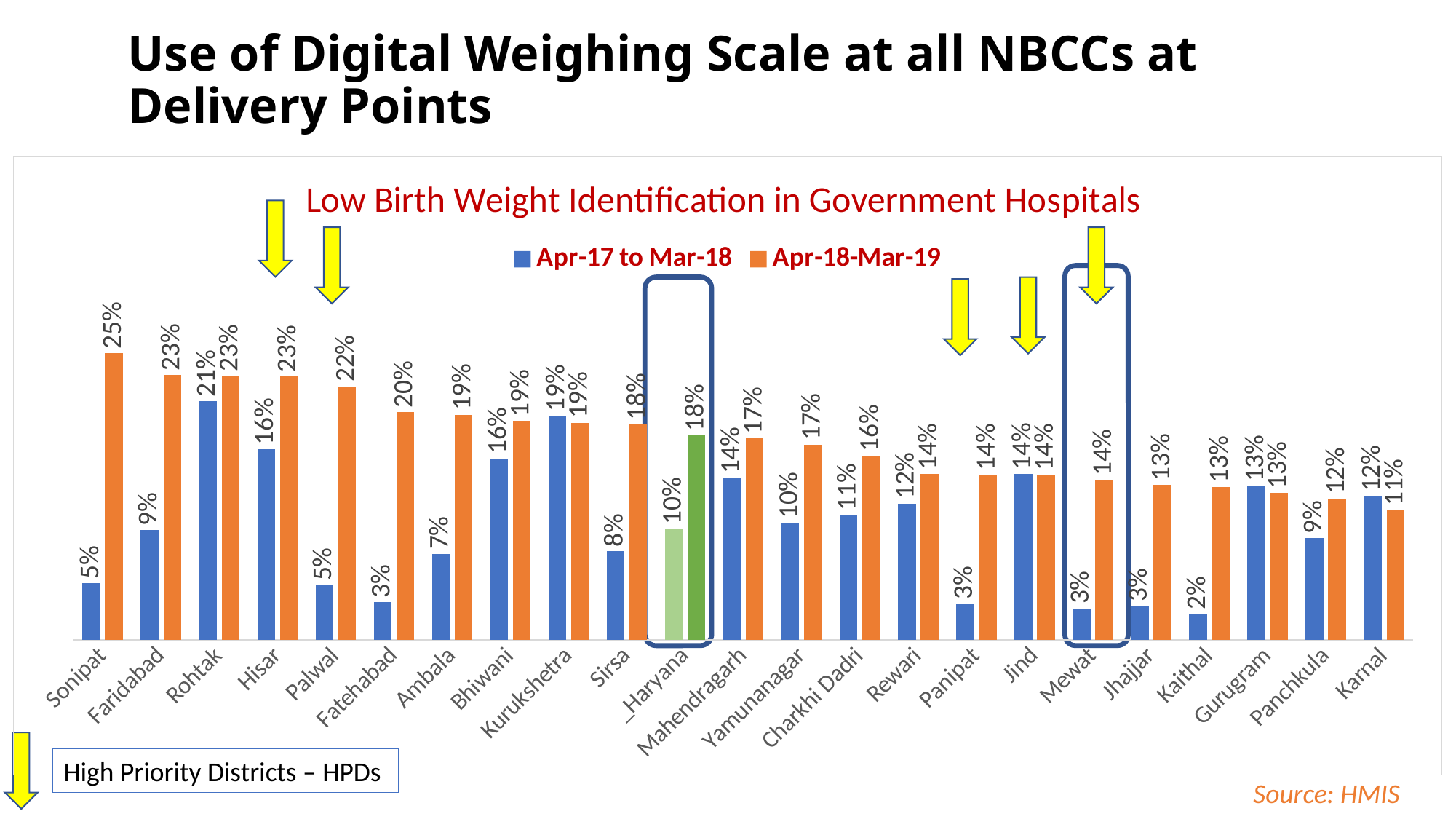
Which district has the lowest Apr-18-Mar-19 value? Karnal What type of chart is shown on the slide? Bar chart What is the Apr-18-Mar-19 value for _Haryana? 18% How many series does the legend list? 2 What is the difference between the Apr-18-Mar-19 and Apr-17 to Mar-18 values for Fatehabad? 17% For Karnal, which is larger: the Apr-17 to Mar-18 value or the Apr-18-Mar-19 value? Apr-17 to Mar-18 What is the difference between the Apr-18-Mar-19 and Apr-17 to Mar-18 values for Sonipat? 20% How many districts/categories are shown on the x axis? 23 Which district has the highest Apr-18-Mar-19 value? Sonipat What is the Apr-18-Mar-19 value for Sonipat? 25% Which district has the lowest Apr-17 to Mar-18 value? Kaithal What is the Apr-17 to Mar-18 value for Rohtak? 21%